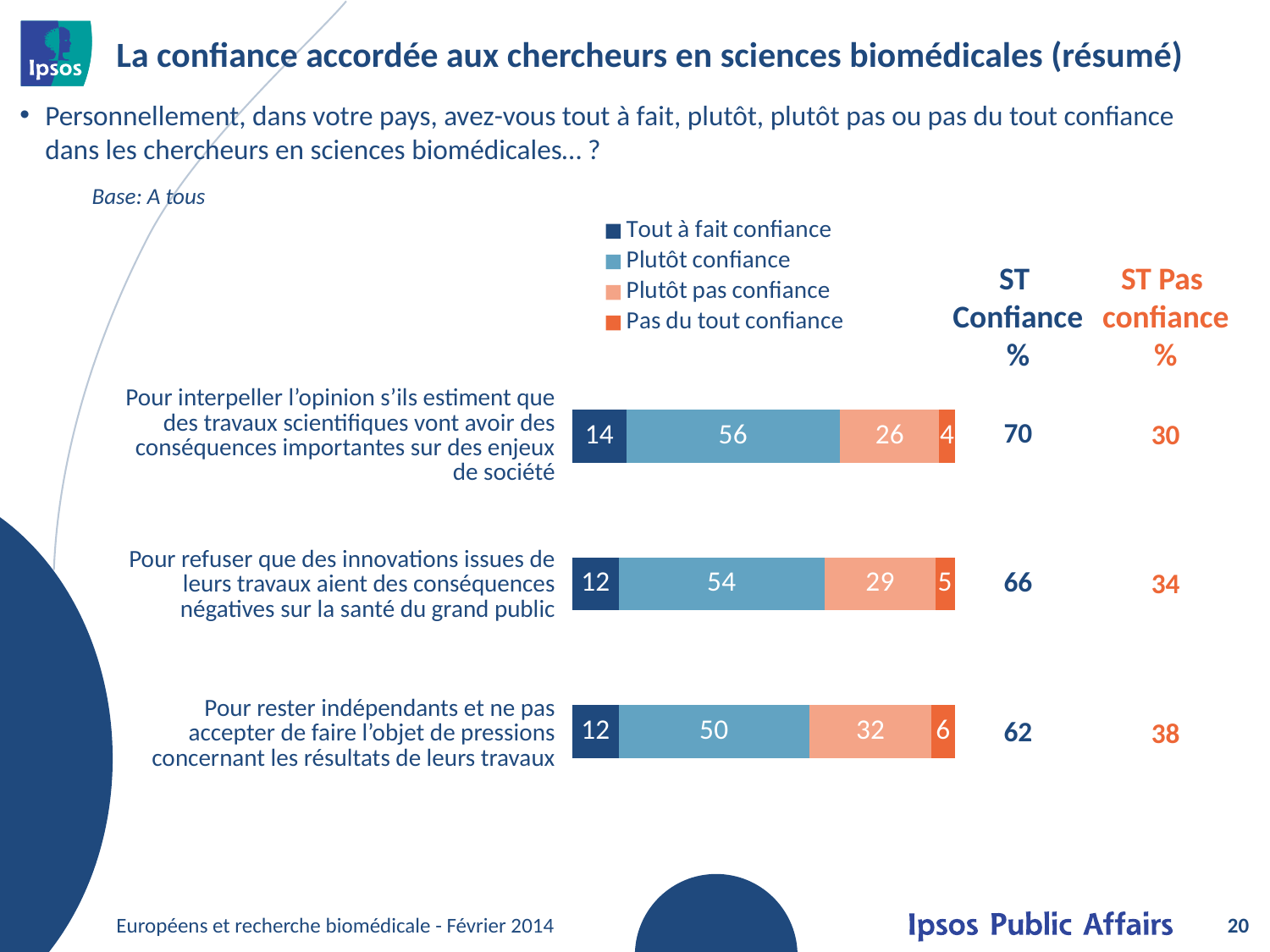
Which statement has the lowest value for "Plutôt confiance"? Pour rester indépendants et ne pas accepter de faire l'objet de pressions concernant les résultats de leurs travaux Which statement has the highest value for "Tout à fait confiance"? Pour interpeller l'opinion s'ils estiment que des travaux scientifiques vont avoir des conséquences importantes sur des enjeux de société What kind of chart is shown on the slide? Stacked bar chart Which is larger: the "Plutôt confiance" value for "Pour refuser que des innovations..." or for "Pour rester indépendants..."? Pour refuser que des innovations issues de leurs travaux aient des conséquences négatives sur la santé du grand public What is the value for "Plutôt pas confiance" for the statement "Pour refuser que des innovations issues de leurs travaux aient des conséquences négatives sur la santé du grand public"? 29 What is the difference between the "Plutôt pas confiance" values for "Pour rester indépendants..." (32) and "Pour interpeller l'opinion..." (26)? 6 What is the total of the "Tout à fait confiance" and "Plutôt confiance" segments for the statement "Pour rester indépendants et ne pas accepter de faire l'objet de pressions concernant les résultats de leurs travaux"? 62 What is the value for "Plutôt confiance" for the statement "Pour interpeller l'opinion s'ils estiment que des travaux scientifiques vont avoir des conséquences importantes sur des enjeux de société"? 56 What is the "ST Confiance %" value shown for the statement "Pour refuser que des innovations issues de leurs travaux aient des conséquences négatives sur la santé du grand public"? 66 How many categories (statements) are plotted in the chart? 3 What is the value for "Pas du tout confiance" for the statement "Pour rester indépendants et ne pas accepter de faire l'objet de pressions concernant les résultats de leurs travaux"? 6 How many series does the legend list? 4